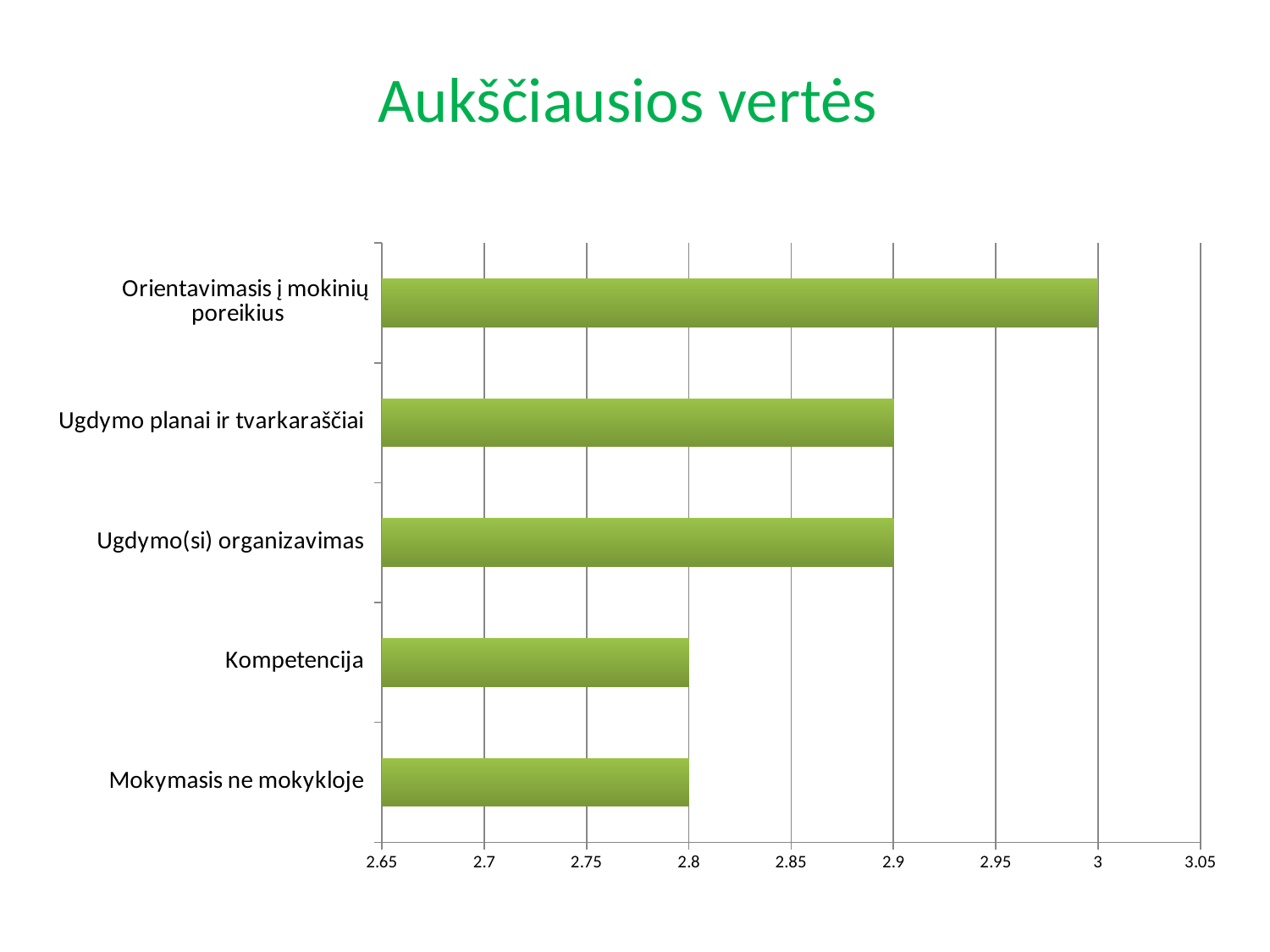
Is the value for Kompetencija greater or less than 2.85? less What is the title of the chart? Aukščiausios vertės How many categories are plotted in the chart? 5 What is the value for Mokymasis ne mokykloje? 2.8 What is the value for Ugdymo planai ir tvarkaraščiai? 2.9 What is the difference between the values for Ugdymo(si) organizavimas and Mokymasis ne mokykloje? 0.1 What is the value for Orientavimasis į mokinių poreikius? 3 What type of chart is shown on the slide? Bar chart What is the value for Kompetencija? 2.8 What is the difference between the values for Orientavimasis į mokinių poreikius and Kompetencija? 0.2 Which category has the highest value? Orientavimasis į mokinių poreikius Which is larger, the value for Ugdymo planai ir tvarkaraščiai or the value for Kompetencija? Ugdymo planai ir tvarkaraščiai